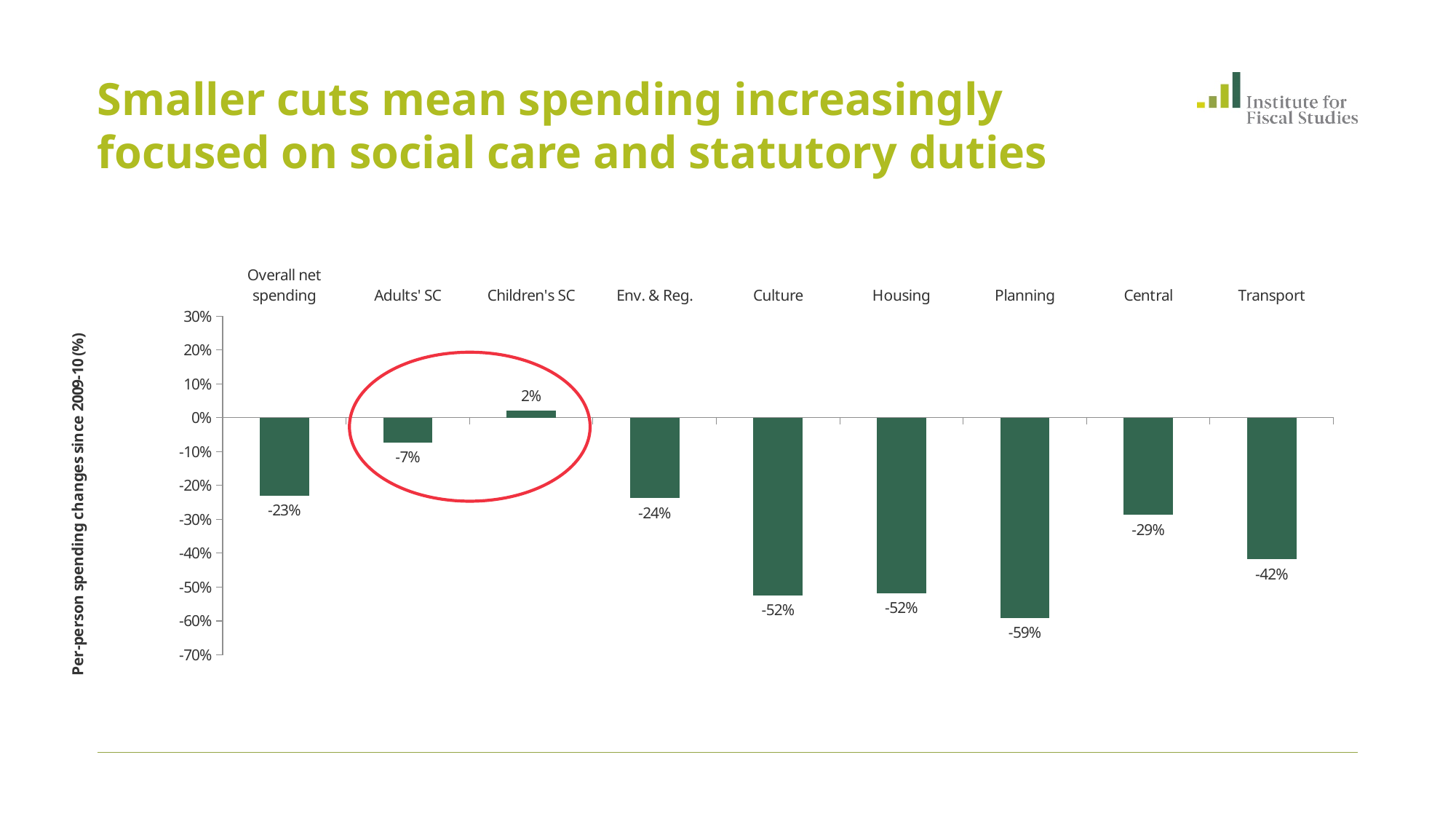
Which two categories are circled in red on the chart? Adults' SC and Children's SC How many categories are shown on the chart? 9 What kind of chart is shown on the slide? Bar chart Which category has the highest value? Children's SC What is the per-person spending change for Adults' SC? -7% Which category has the largest cut (lowest value)? Planning What is the label of the vertical axis? Per-person spending changes since 2009-10 (%) What is the per-person spending change for Transport? -42% What is the per-person spending change for Children's SC? 2% What is the per-person spending change for Overall net spending? -23% Which has a larger cut, Transport or Central? Transport What is the difference between the values for Planning and Central? 30 percentage points